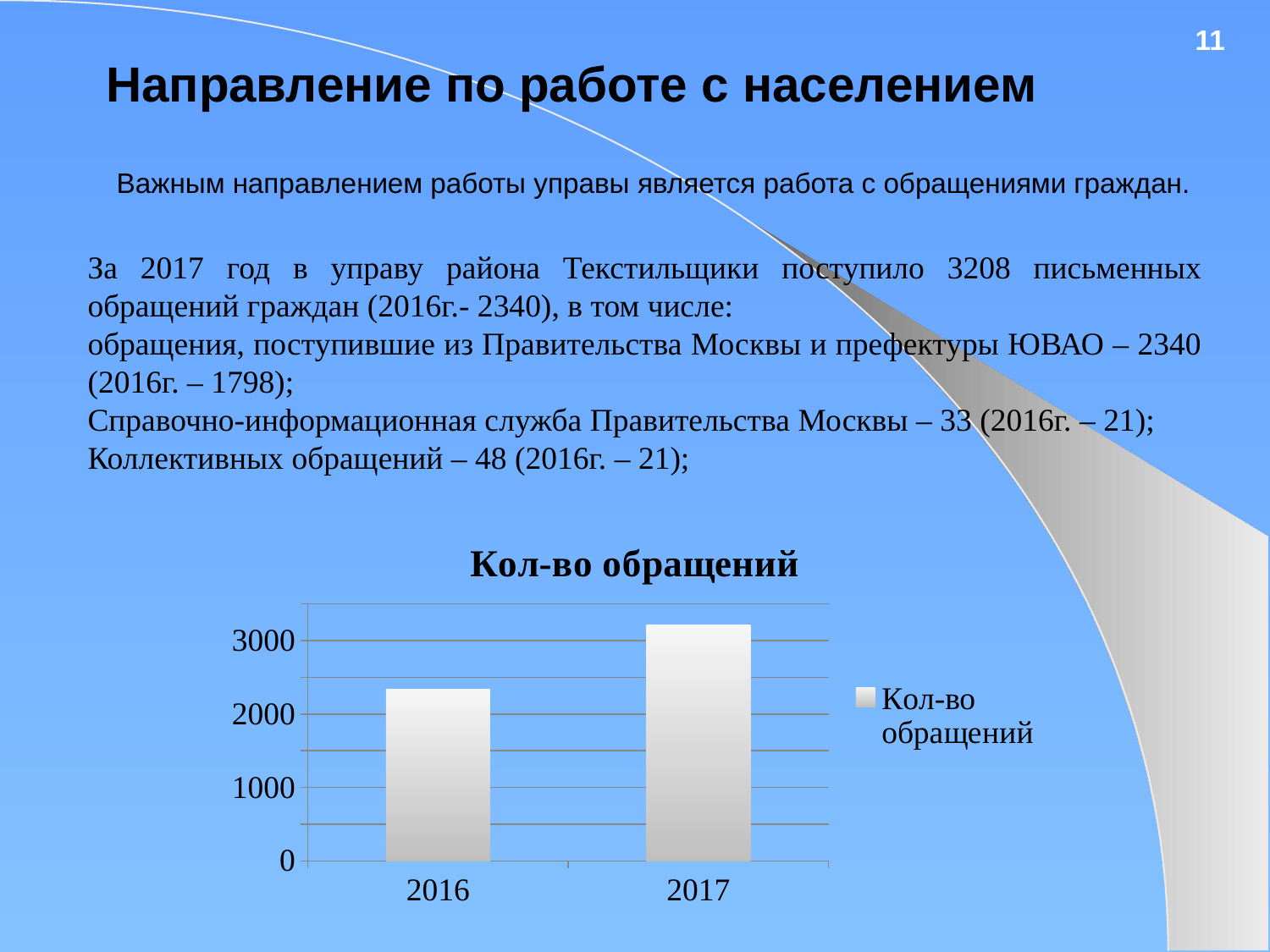
Is the bar for 2017 greater or less than 3000? greater How many categories are shown on the x axis of the chart? 2 Which year has the higher bar in the chart? 2017 Is the bar for 2016 greater or less than 2000? greater What is the name of the series shown in the chart legend? Кол-во обращений Do the values rise or fall from 2016 to 2017? rise Which year has the lower bar in the chart? 2016 What kind of chart is shown on the slide? bar chart Is the value for 2017 larger or smaller than the value for 2016? larger How many series does the chart legend list? 1 Is the bar for 2016 greater or less than 3000? less What is the title of the chart? Кол-во обращений